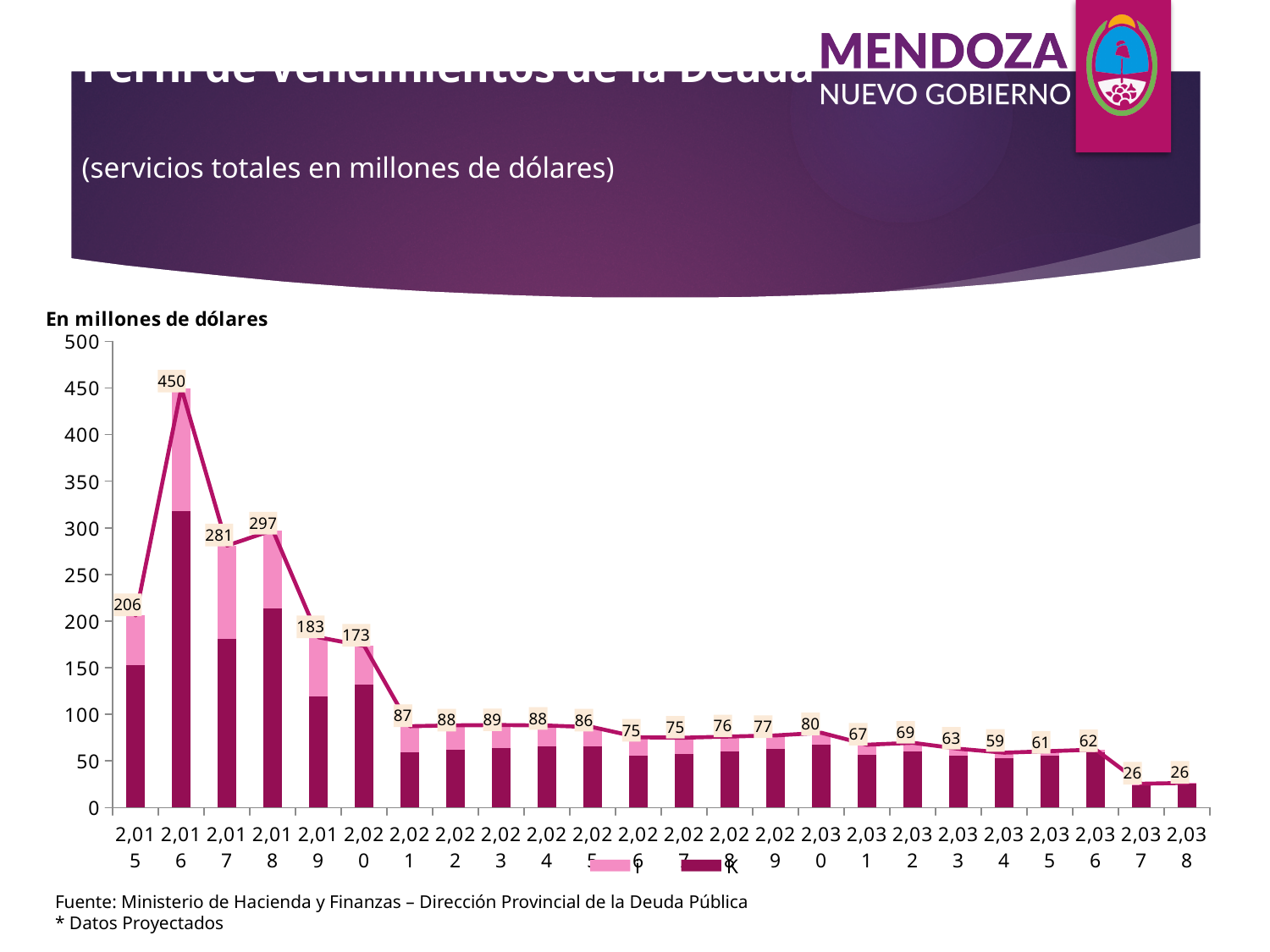
What is the total value shown for 2016? 450 What is the total value shown for 2021? 87 What is the title printed above the chart? En millones de dólares What is the lowest total value shown on the chart? 26 Do the total values generally rise or fall from 2020 to 2038? Fall Is the value for 2019 greater or less than 150? greater Which year has the larger total value, 2017 or 2018? 2018 What is the difference between the total values for 2016 and 2015? 244 How many years are shown on the x axis? 24 What kind of chart is this? Bar chart with a line What is the total value shown for 2015? 206 Which year has the highest total value? 2016